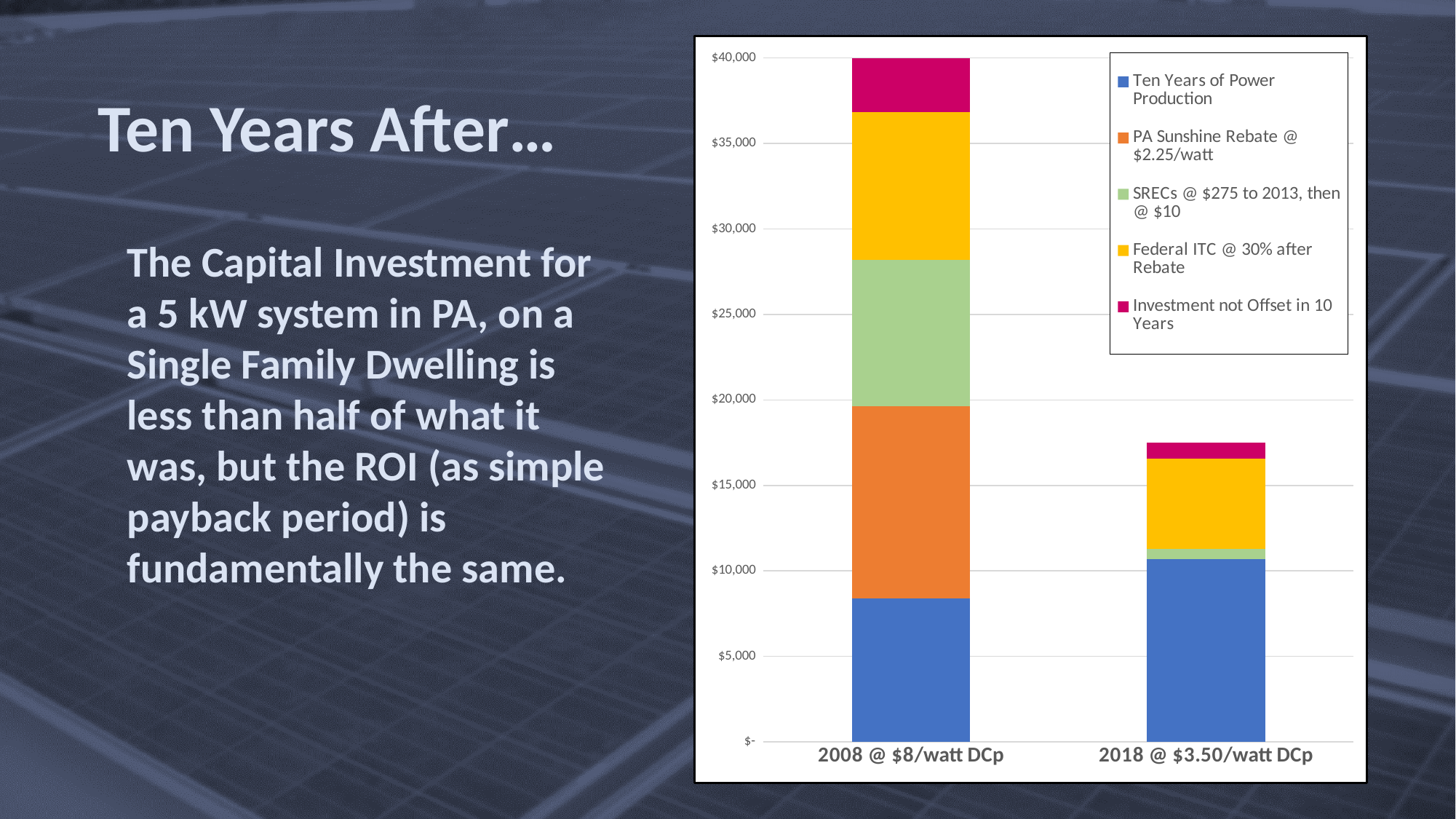
Which category has the taller stacked bar? 2008 @ $8/watt DCp Is the Ten Years of Power Production segment for 2008 @ $8/watt DCp greater or less than $10,000? less Which series is listed last in the chart's legend? Investment not Offset in 10 Years How many categories are shown on the x axis of the chart? 2 Which category has the larger Ten Years of Power Production segment, 2008 @ $8/watt DCp or 2018 @ $3.50/watt DCp? 2018 @ $3.50/watt DCp Is the total of the stacked bar for 2018 @ $3.50/watt DCp greater or less than $20,000? less How many series does the chart's legend list? 5 What kind of chart is shown on the slide? Stacked bar chart Is the Ten Years of Power Production segment for 2018 @ $3.50/watt DCp greater or less than $10,000? greater Which category has the shorter stacked bar? 2018 @ $3.50/watt DCp Which series is shown in orange in the chart's legend? PA Sunshine Rebate @ $2.25/watt